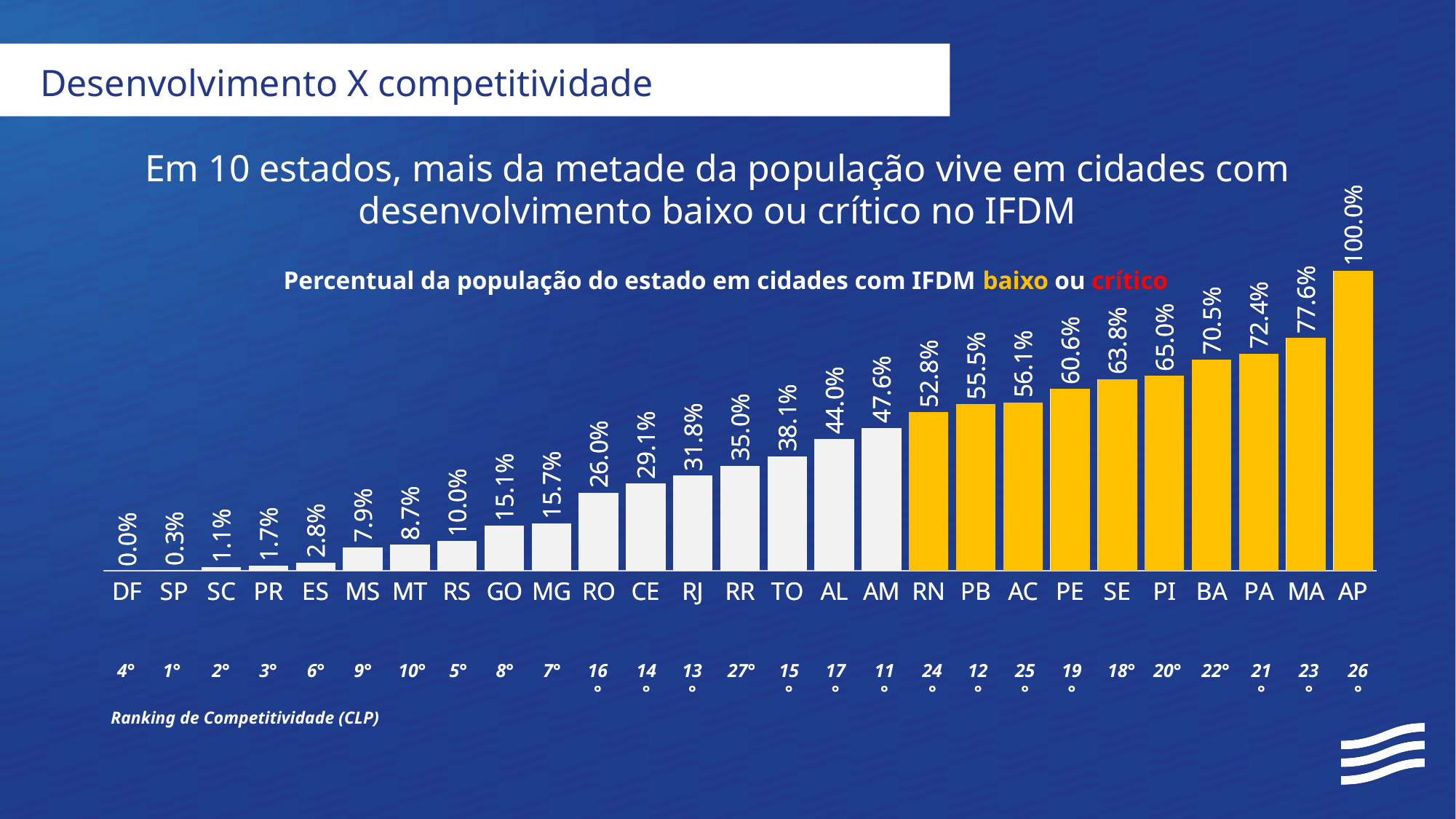
How many bars are coloured yellow? 10 What is the difference between the values for AM and AL? 3.6% What is the value for PE? 60.6% What is the difference between the values for AP and MA? 22.4% Which state has the highest value? AP How many states are shown on the x axis? 27 What kind of chart is this? Bar chart Do the values rise or fall from left to right along the x axis? Rise Which has a larger value, RO or TO? TO What is the value for RJ? 31.8% What is the value for MA? 77.6% Which state has the lowest value? DF